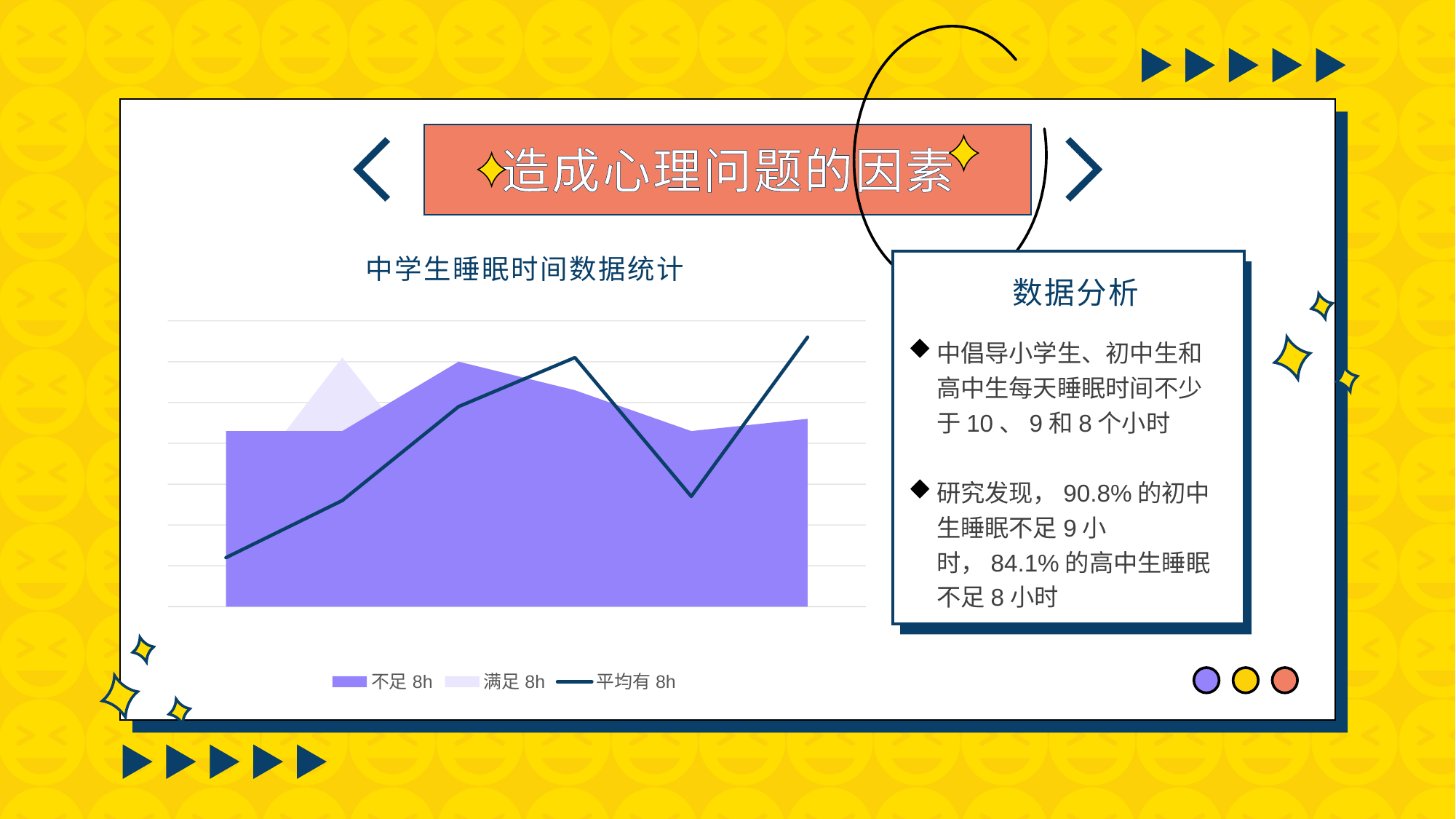
What are the three series named in the chart's legend? 不足 8h, 满足 8h, 平均有 8h How many series does the chart's legend list? 3 What kind of chart is shown on the slide? A combination of an area chart and a line chart How many data points does the 平均有 8h line have? 6 What is the title of the chart on the slide? 中学生睡眠时间数据统计 At which point does the 平均有 8h line reach its highest value? The last (rightmost) point At which point does the 平均有 8h line reach its lowest value? The first (leftmost) point Which series in the chart is drawn as a line rather than a filled area? 平均有 8h Is the last point of the 平均有 8h line higher or lower than its first point? Higher